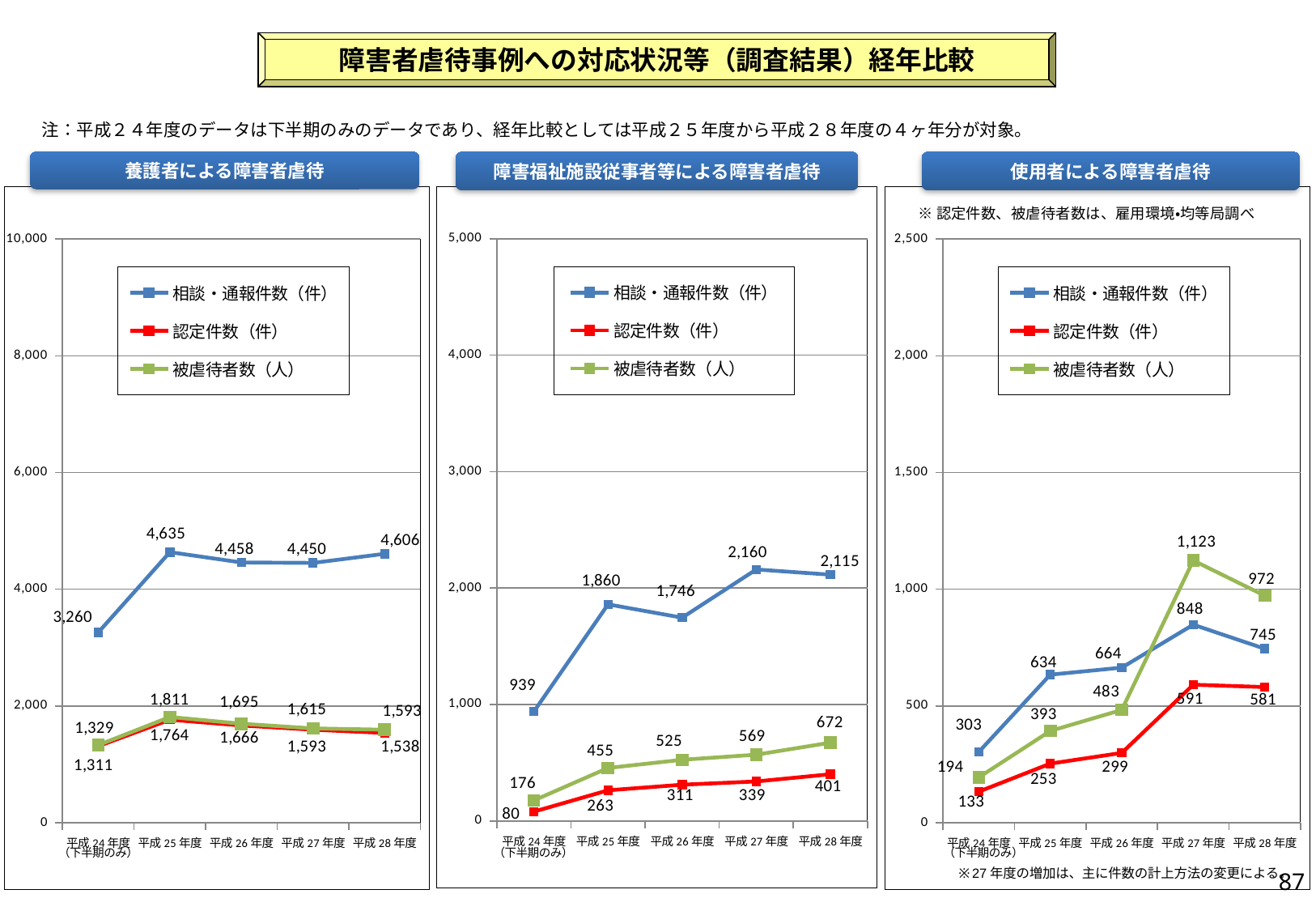
In the 障害福祉施設従事者等による障害者虐待 chart, does 認定件数（件） rise or fall from 平成24年度 to 平成28年度? rise In the 養護者による障害者虐待 chart, what is the difference between 被虐待者数（人） and 認定件数（件） in 平成28年度? 55 In the 使用者による障害者虐待 chart, what is the value of 被虐待者数（人） for 平成27年度? 1,123 In the 使用者による障害者虐待 chart, what is the difference between 相談・通報件数（件） in 平成27年度 and 平成28年度? 103 In the 障害福祉施設従事者等による障害者虐待 chart, which year has the highest 相談・通報件数（件）? 平成27年度 In the 養護者による障害者虐待 chart, what is the value of 相談・通報件数（件） for 平成25年度? 4,635 How many years (data points per series) are plotted in the 障害福祉施設従事者等による障害者虐待 chart? 5 In the 養護者による障害者虐待 chart, which year has the lowest 相談・通報件数（件）? 平成24年度（下半期のみ） In the 使用者による障害者虐待 chart, which is larger in 平成28年度: 相談・通報件数（件） or 被虐待者数（人）? 被虐待者数（人） How many series does the legend list in the 養護者による障害者虐待 chart? 3 What kind of chart is the 使用者による障害者虐待 chart? line chart In the 障害福祉施設従事者等による障害者虐待 chart, what is the value of 認定件数（件） for 平成28年度? 401